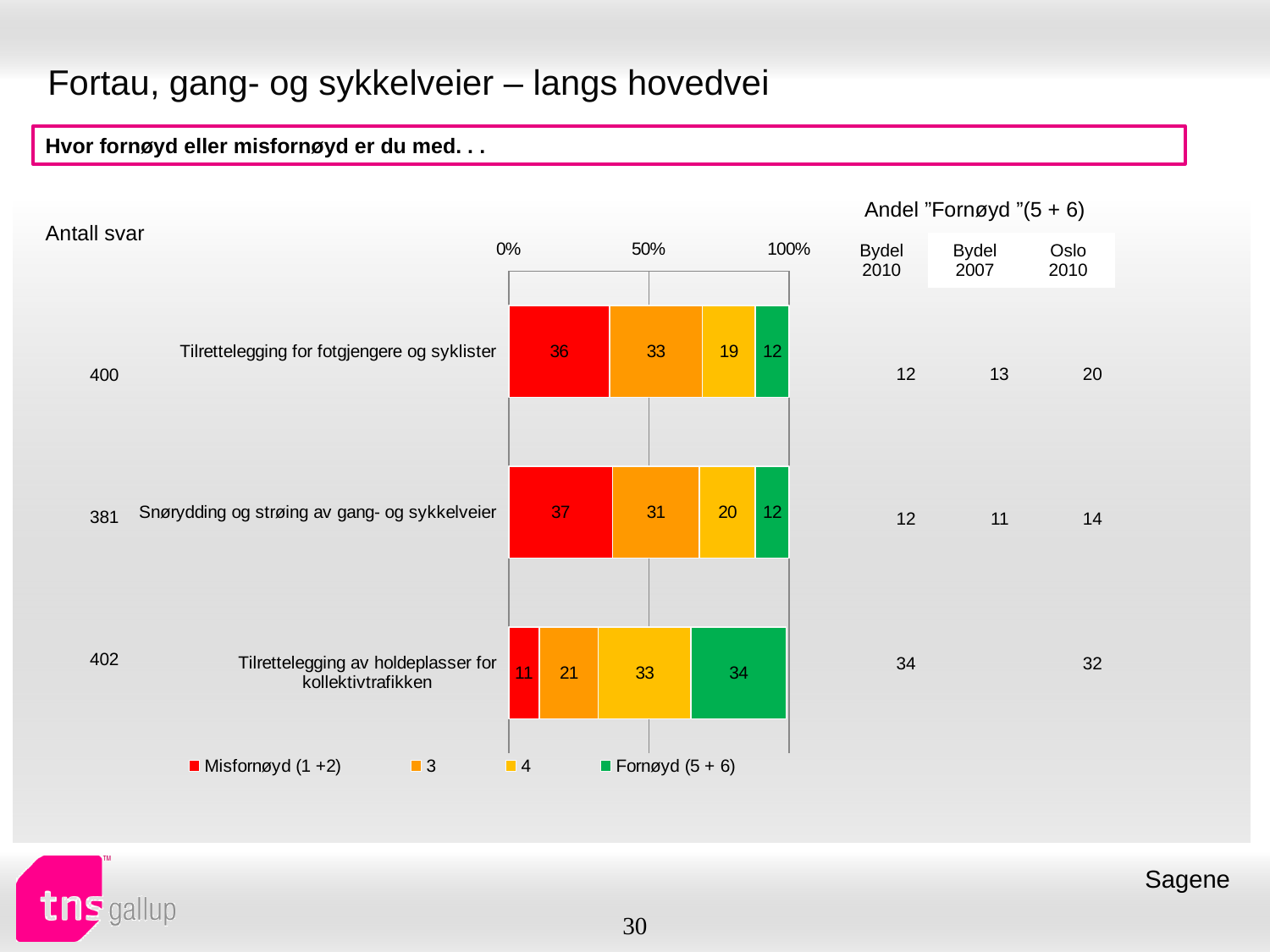
What is the total of the stacked bar for "Tilrettelegging av holdeplasser for kollektivtrafikken"? 99 What is the difference between the "Misfornøyd (1 +2)" values for "Snørydding og strøing av gang- og sykkelveier" and "Tilrettelegging av holdeplasser for kollektivtrafikken"? 26 How many series does the legend list? 4 What colour represents the "Fornøyd (5 + 6)" series in the chart? Green Which is larger for "Tilrettelegging for fotgjengere og syklister": the value for series "3" or the value for series "4"? 3 How many categories are shown in the chart? 3 Which category has the lowest "Misfornøyd (1 +2)" value? Tilrettelegging av holdeplasser for kollektivtrafikken What kind of chart is shown on the slide? Stacked bar chart What is the value of "Fornøyd (5 + 6)" for "Tilrettelegging av holdeplasser for kollektivtrafikken"? 34 Which category has the highest "Fornøyd (5 + 6)" value? Tilrettelegging av holdeplasser for kollektivtrafikken What is the value of series "3" for "Snørydding og strøing av gang- og sykkelveier"? 31 What is the value of "Misfornøyd (1 +2)" for "Tilrettelegging for fotgjengere og syklister"? 36